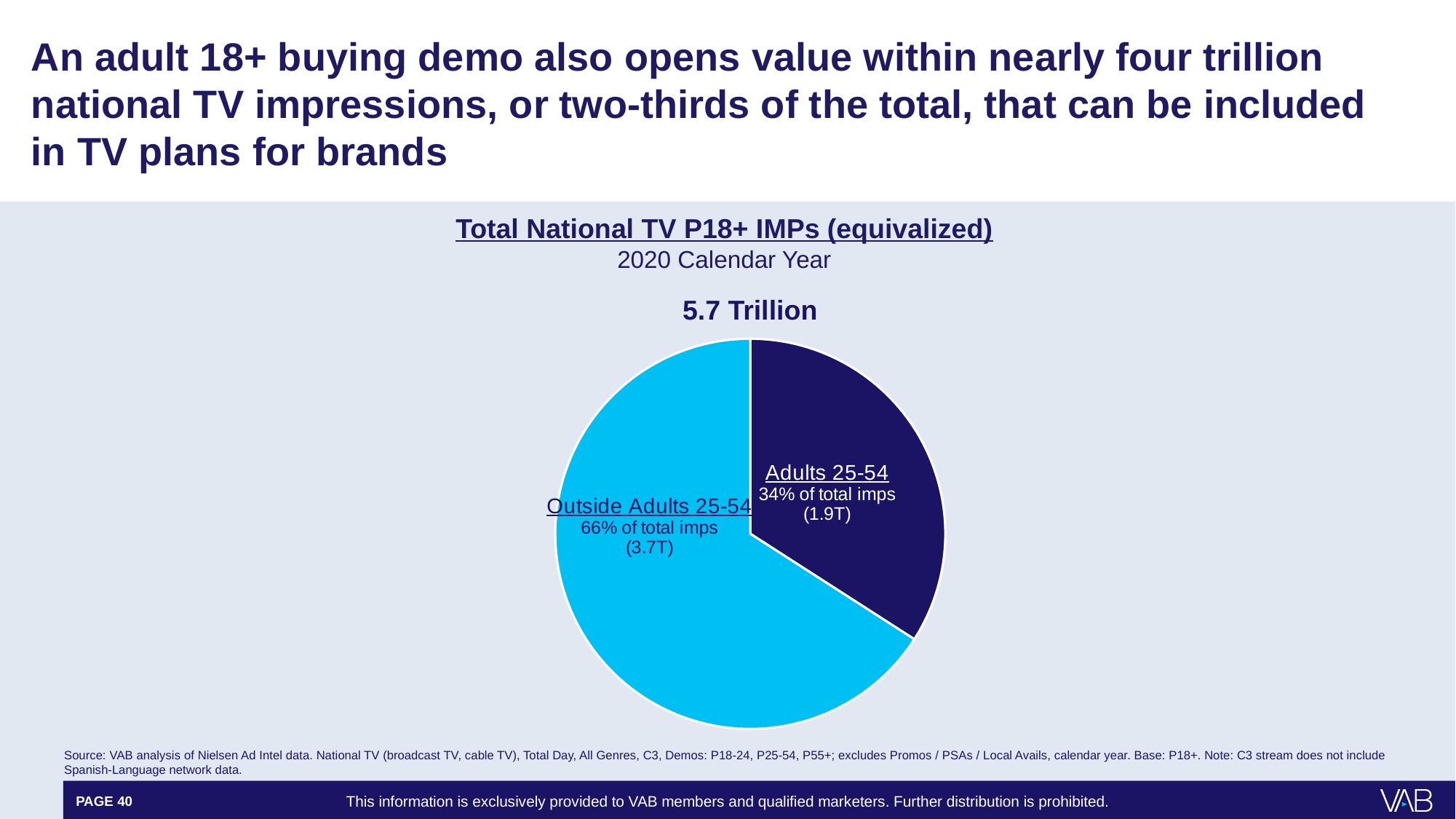
How many slices does the pie chart have? 2 Which slice of the pie is the smallest? Adults 25-54 What is the title of the chart? Total National TV P18+ IMPs (equivalized) How many impressions are attributed to Adults 25-54? 1.9T How many impressions are attributed to Outside Adults 25-54? 3.7T What share of total impressions does the Outside Adults 25-54 slice represent? 66% What total value is shown above the pie chart? 5.7 Trillion What is the difference in percentage points between the Outside Adults 25-54 share and the Adults 25-54 share? 32 percentage points Which is larger, the share for Adults 25-54 or the share for Outside Adults 25-54? Outside Adults 25-54 What share of total impressions does the Adults 25-54 slice represent? 34% What kind of chart is shown on the slide? pie chart Which slice of the pie is the largest? Outside Adults 25-54